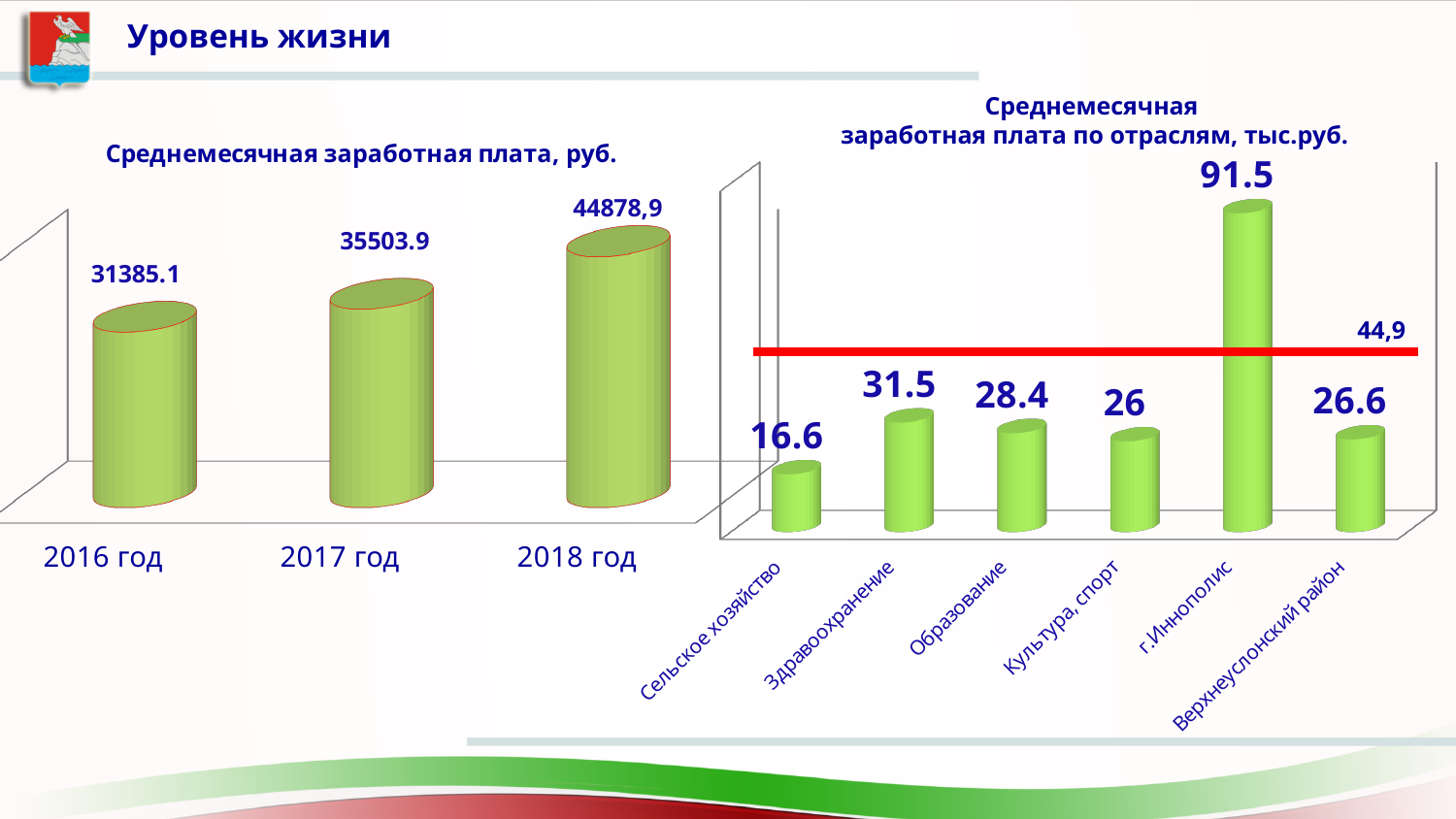
In the chart titled 'Среднемесячная заработная плата по отраслям, тыс.руб.', what is the difference between г.Иннополис and Сельское хозяйство? 74.9 In the chart titled 'Среднемесячная заработная плата, руб.', which year has the lowest value? 2016 год In the chart titled 'Среднемесячная заработная плата, руб.', what is the value for 2017 год? 35503.9 In the chart titled 'Среднемесячная заработная плата, руб.', how many years are shown? 3 In the chart titled 'Среднемесячная заработная плата по отраслям, тыс.руб.', what is the value for Здравоохранение? 31.5 In the chart titled 'Среднемесячная заработная плата, руб.', what is the difference between the values for 2017 год and 2016 год? 4118.8 In the chart titled 'Среднемесячная заработная плата по отраслям, тыс.руб.', which is larger: Образование or Культура, спорт? Образование In the chart titled 'Среднемесячная заработная плата по отраслям, тыс.руб.', which category has the lowest value? Сельское хозяйство In the chart titled 'Среднемесячная заработная плата, руб.', do the values rise or fall from 2016 год to 2018 год? rise In the chart titled 'Среднемесячная заработная плата, руб.', what is the value for 2018 год? 44878,9 In the chart titled 'Среднемесячная заработная плата по отраслям, тыс.руб.', what is the value for г.Иннополис? 91.5 In the chart titled 'Среднемесячная заработная плата по отраслям, тыс.руб.', what value is marked by the red horizontal line? 44,9